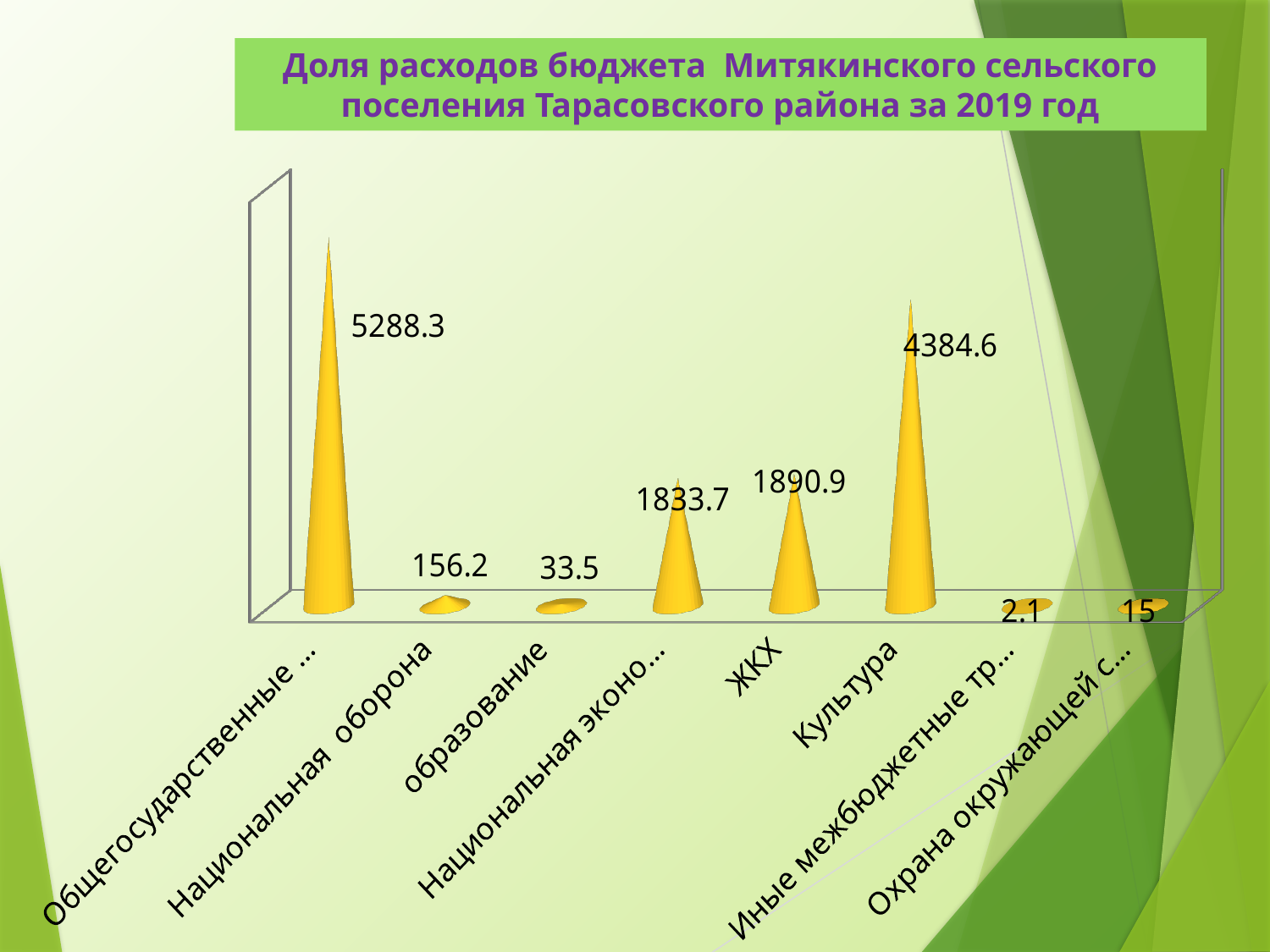
What is the value for Национальная оборона? 156.2 How many categories are shown on the chart? 8 What is the value for Культура? 4384.6 What is the difference between the values for Культура and ЖКХ? 2493.7 Which is larger, the value for ЖКХ or the value for Культура? Культура What kind of chart is shown on the slide? Bar chart What colour are the bars on the chart? Yellow What is the value for образование? 33.5 What is the difference between the values for Национальная оборона and образование? 122.7 What is the lowest value shown on the chart? 2.1 What is the highest value shown on the chart? 5288.3 What is the value for ЖКХ? 1890.9